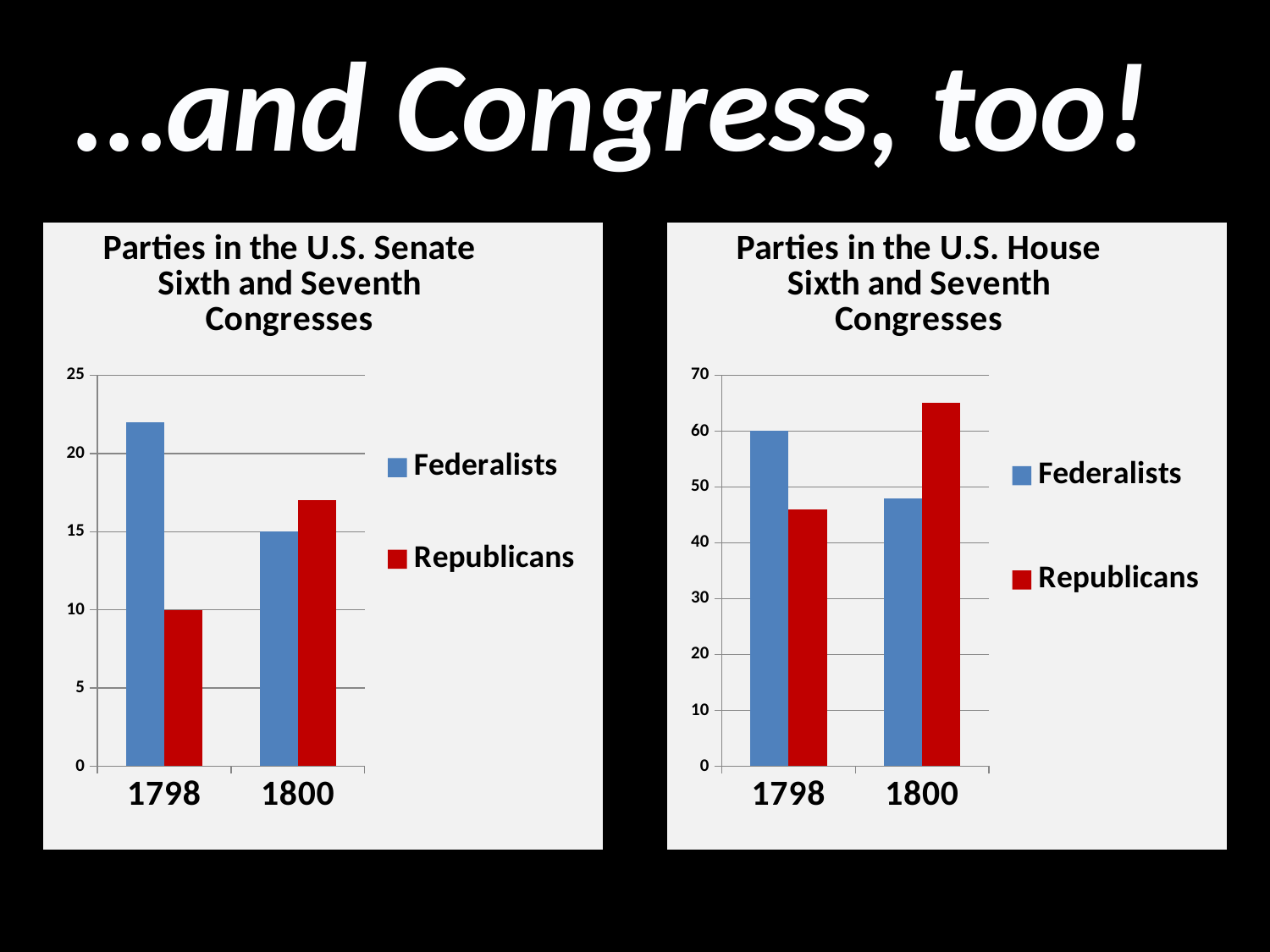
On the 'Parties in the U.S. Senate' chart, how many series does the legend list? 2 On the 'Parties in the U.S. Senate' chart, what is the value for Federalists in 1800? 15 On the 'Parties in the U.S. Senate' chart, how many years are shown on the x axis? 2 On the 'Parties in the U.S. Senate' chart, which party has the larger value in 1800, Federalists or Republicans? Republicans On the 'Parties in the U.S. House' chart, which party has the larger value in 1798, Federalists or Republicans? Federalists On the 'Parties in the U.S. House' chart, is the value for Republicans in 1800 greater or less than 60? greater On the 'Parties in the U.S. House' chart, what is the value for Federalists in 1798? 60 On the 'Parties in the U.S. Senate' chart, what is the value for Republicans in 1798? 10 On the 'Parties in the U.S. Senate' chart, what kind of chart is shown? bar chart On the 'Parties in the U.S. House' chart, do the Republicans' values rise or fall from 1798 to 1800? rise On the 'Parties in the U.S. Senate' chart, is the value for Federalists in 1798 greater or less than 20? greater On the 'Parties in the U.S. House' chart, what colour represents Republicans in the legend? red